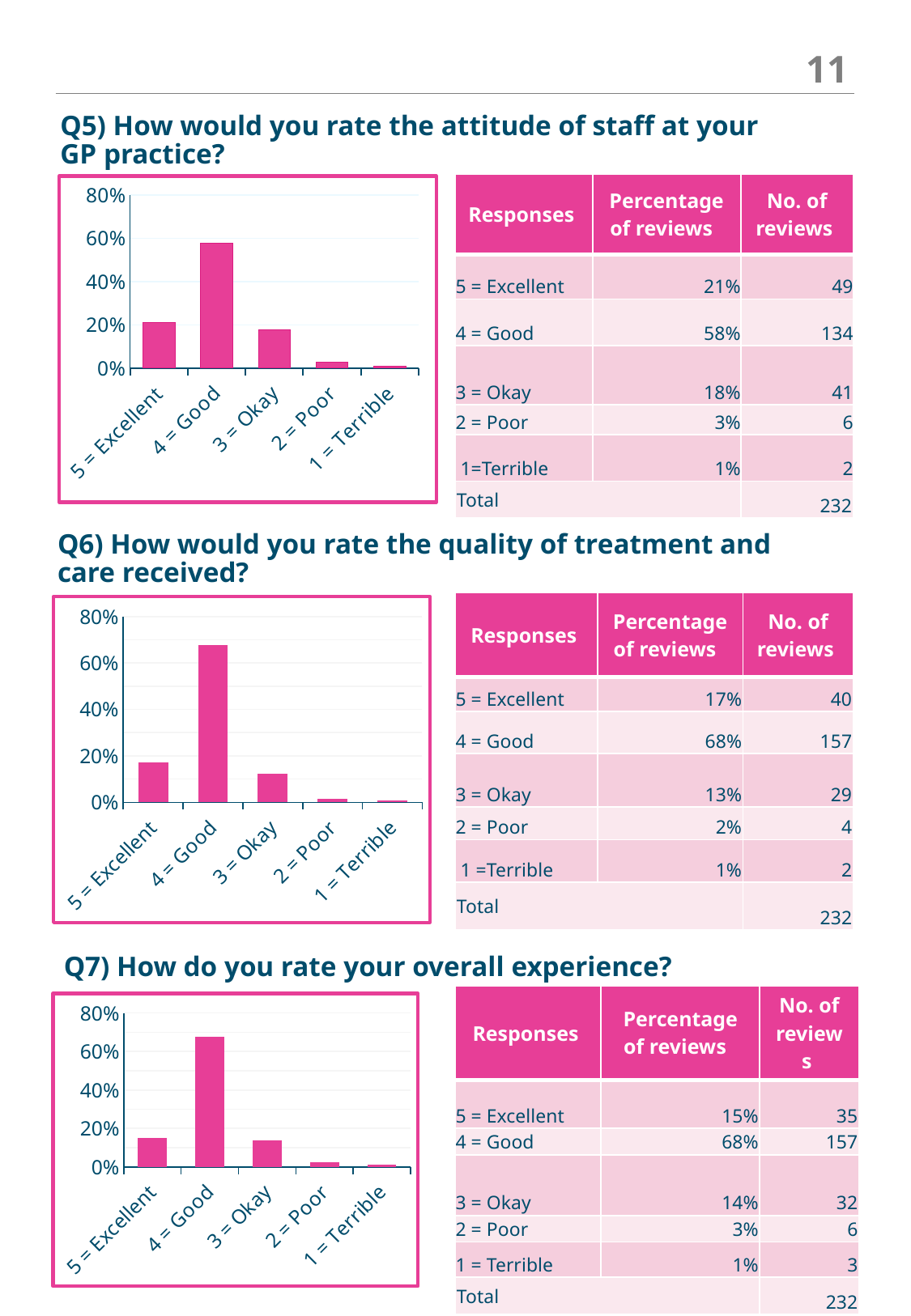
In the Q6 chart (quality of treatment and care), is the value for 4 = Good greater or less than 60%? greater In the Q6 chart (quality of treatment and care), which response category has the lowest bar? 1 = Terrible In the Q6 chart (quality of treatment and care), what is the difference in percentage points between 4 = Good and 3 = Okay? 55% In the Q7 chart (overall experience), which is larger, the value for 5 = Excellent or the value for 3 = Okay? 5 = Excellent In the Q5 chart (attitude of staff at your GP practice), what kind of chart is shown? bar chart In the Q5 chart (attitude of staff), is the value for 5 = Excellent greater or less than 40%? less In the Q6 chart (quality of treatment and care), what percentage of reviews rated the care as 5 = Excellent? 17% In the Q7 chart (overall experience), what percentage of reviews rated the overall experience as 2 = Poor? 3% In the Q5 chart (attitude of staff), which response category has the highest bar? 4 = Good In the Q7 chart (overall experience), what is the highest value shown on the y axis? 80% In the Q5 chart (attitude of staff), what percentage of reviews rated the staff attitude as 4 = Good? 58% In the Q5 chart (attitude of staff), how many response categories are shown on the x axis? 5